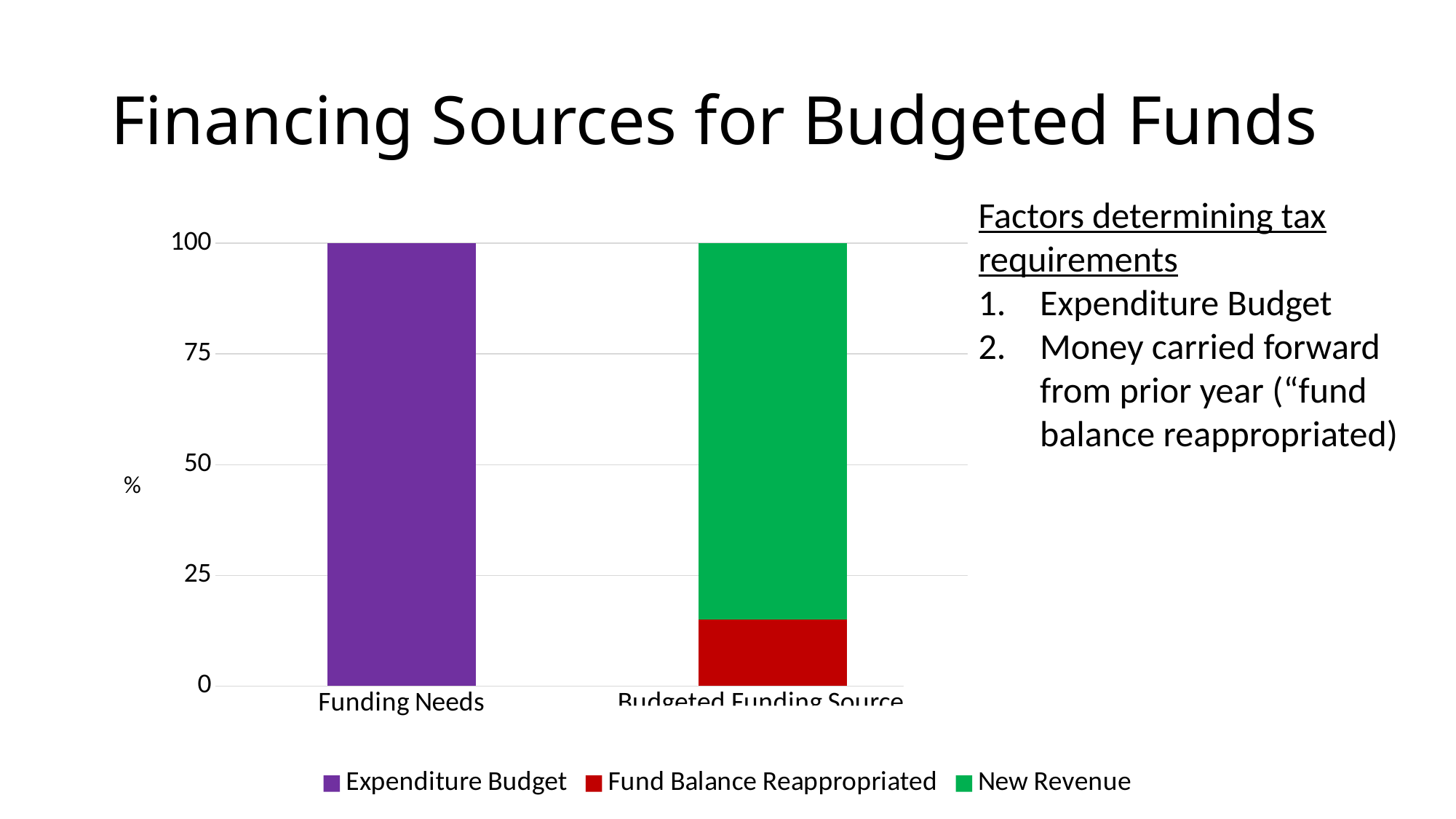
What is the total of the stacked bar for Budgeted Funding Source? 100 What label is shown on the y axis? % How many series does the legend list? 3 Which series appears only in the Funding Needs bar? Expenditure Budget Within the Budgeted Funding Source bar, which is larger: New Revenue or Fund Balance Reappropriated? New Revenue What is the value of Expenditure Budget for Funding Needs? 100 How many categories are shown on the x axis? 2 Which series is shown in purple? Expenditure Budget Is the value for New Revenue in Budgeted Funding Source greater or less than 50? greater Is the value for Fund Balance Reappropriated in Budgeted Funding Source greater or less than 25? less What kind of chart is shown on the slide? stacked bar chart What is the title of the slide containing the chart? Financing Sources for Budgeted Funds